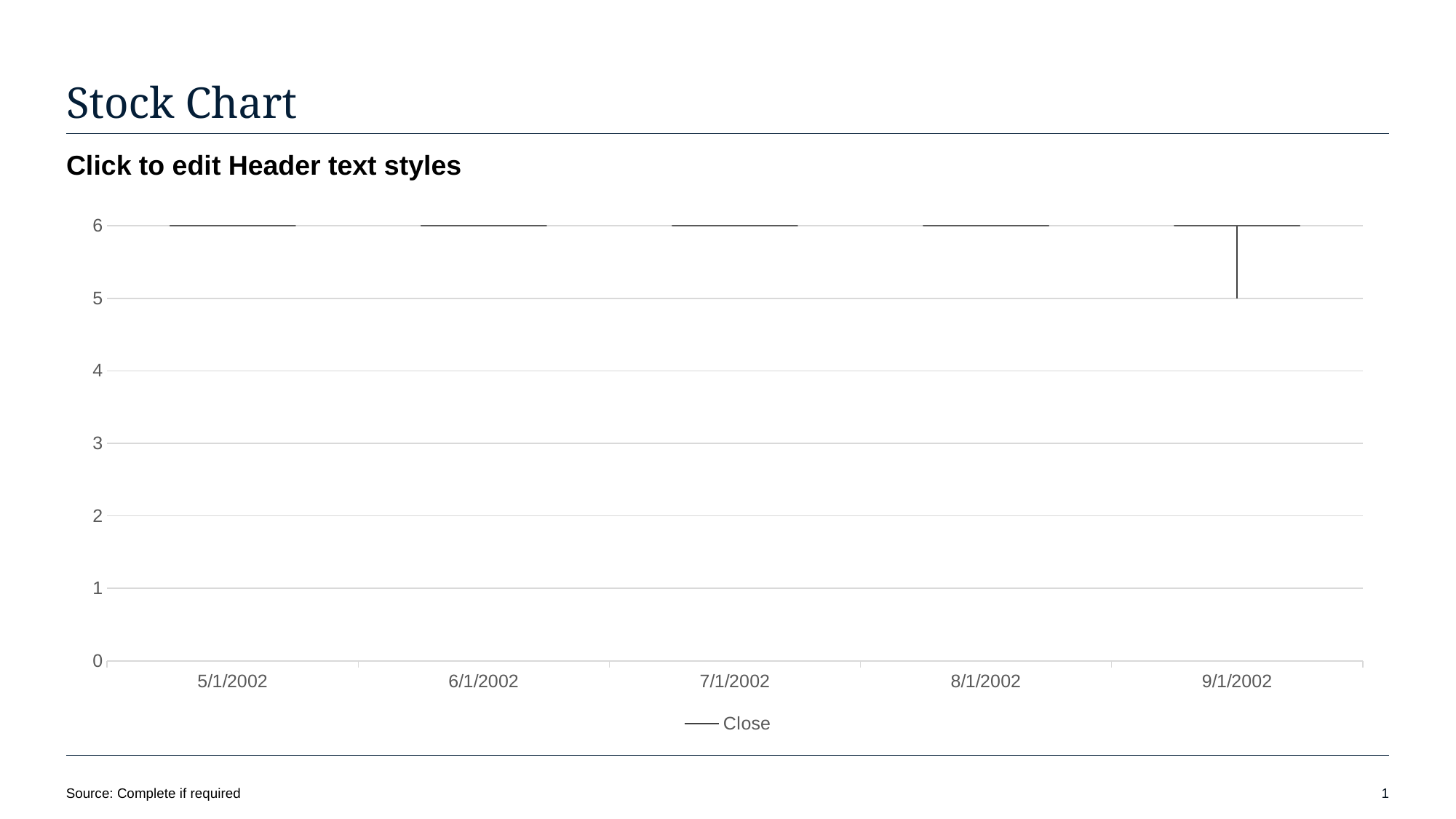
What kind of chart is shown on the slide? Stock chart How many dates are shown on the x axis? 5 What is the Close value for 8/1/2002? 6 Is the Close value for 7/1/2002 greater or less than 4? greater Do the Close values rise, fall or stay flat from 5/1/2002 to 9/1/2002? stay flat How many series does the legend list? 1 Which date shows a vertical high-low line extending below the Close marker? 9/1/2002 What is the Close value for 5/1/2002? 6 Is the Close value for 6/1/2002 greater or less than 3? greater What is the title of the chart on the slide? Stock Chart What series name is shown in the legend? Close What is the lowest value reached by the vertical line at 9/1/2002? 5